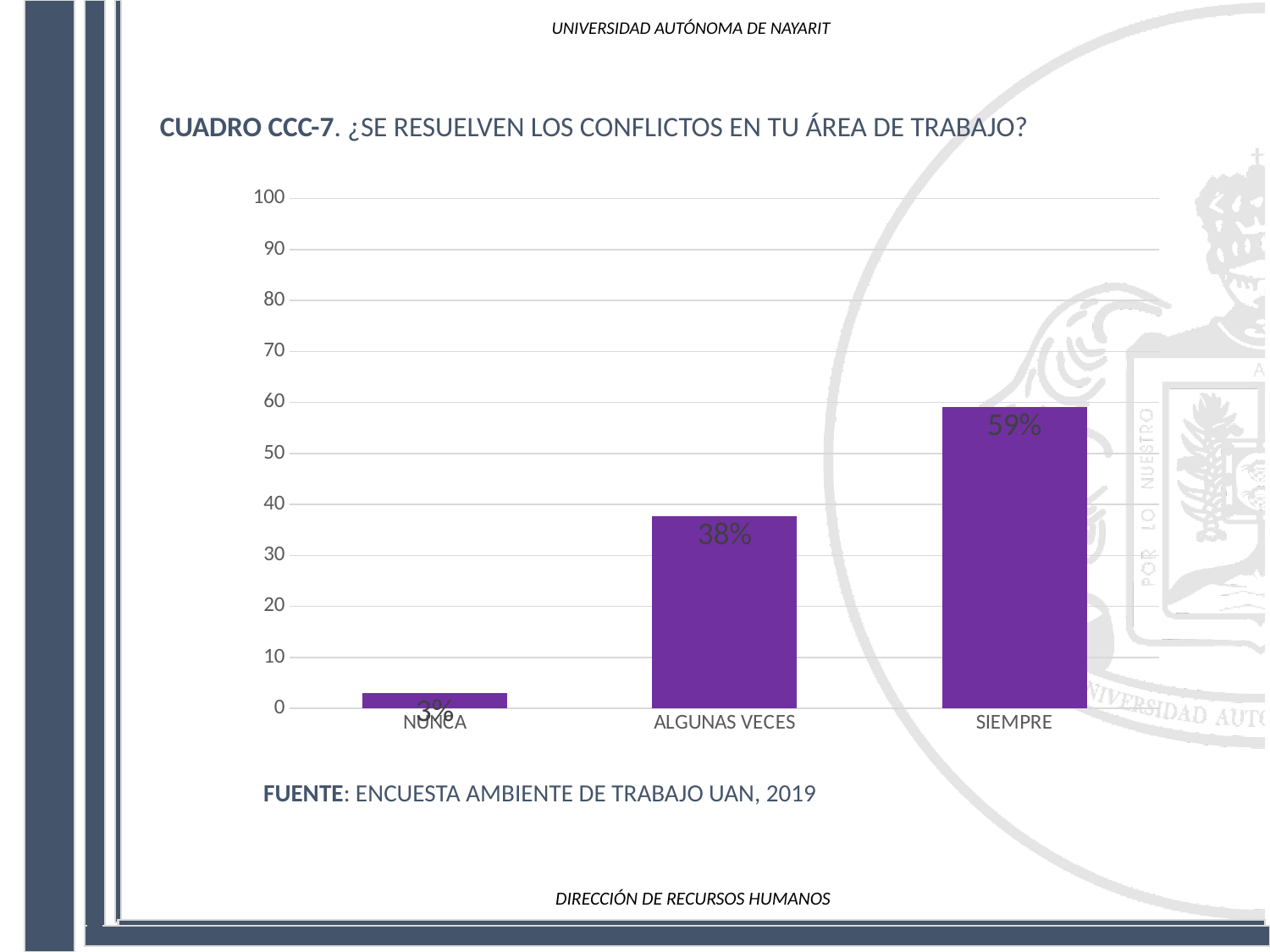
What is the value for NUNCA? 3% Which is larger, the value for ALGUNAS VECES or the value for NUNCA? ALGUNAS VECES Is the value for SIEMPRE greater or less than 50? greater Which category has the highest value? SIEMPRE Do the values rise or fall from left to right along the x axis? rise What is the value for SIEMPRE? 59% Which category has the lowest value? NUNCA What kind of chart is shown on the slide? bar chart How many categories are shown on the x axis? 3 Is the value for ALGUNAS VECES greater or less than 40? less What is the difference between the values for SIEMPRE and ALGUNAS VECES? 21% What is the value for ALGUNAS VECES? 38%